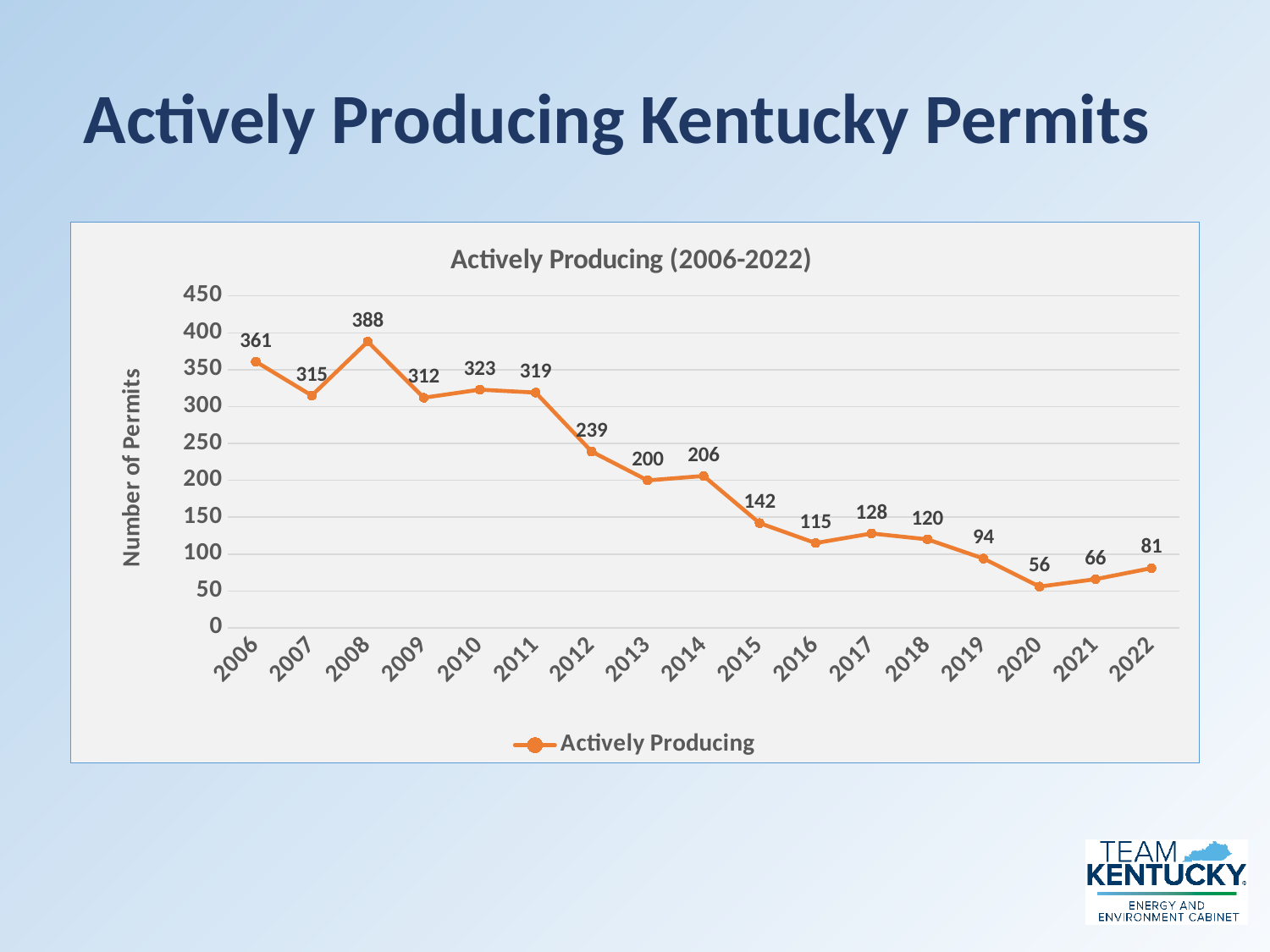
What is the number of actively producing permits in 2008? 388 What is the number of actively producing permits in 2015? 142 What kind of chart is shown on the slide? line chart What is the label of the y axis? Number of Permits What is the difference between the number of permits in 2006 and in 2022? 280 How many years are plotted on the chart? 17 What is the number of actively producing permits in 2022? 81 Is the value for 2012 greater or less than 250? less Which year has the highest number of actively producing permits? 2008 Which year has more actively producing permits, 2017 or 2018? 2017 How many series does the legend list? 1 Which year has the lowest number of actively producing permits? 2020